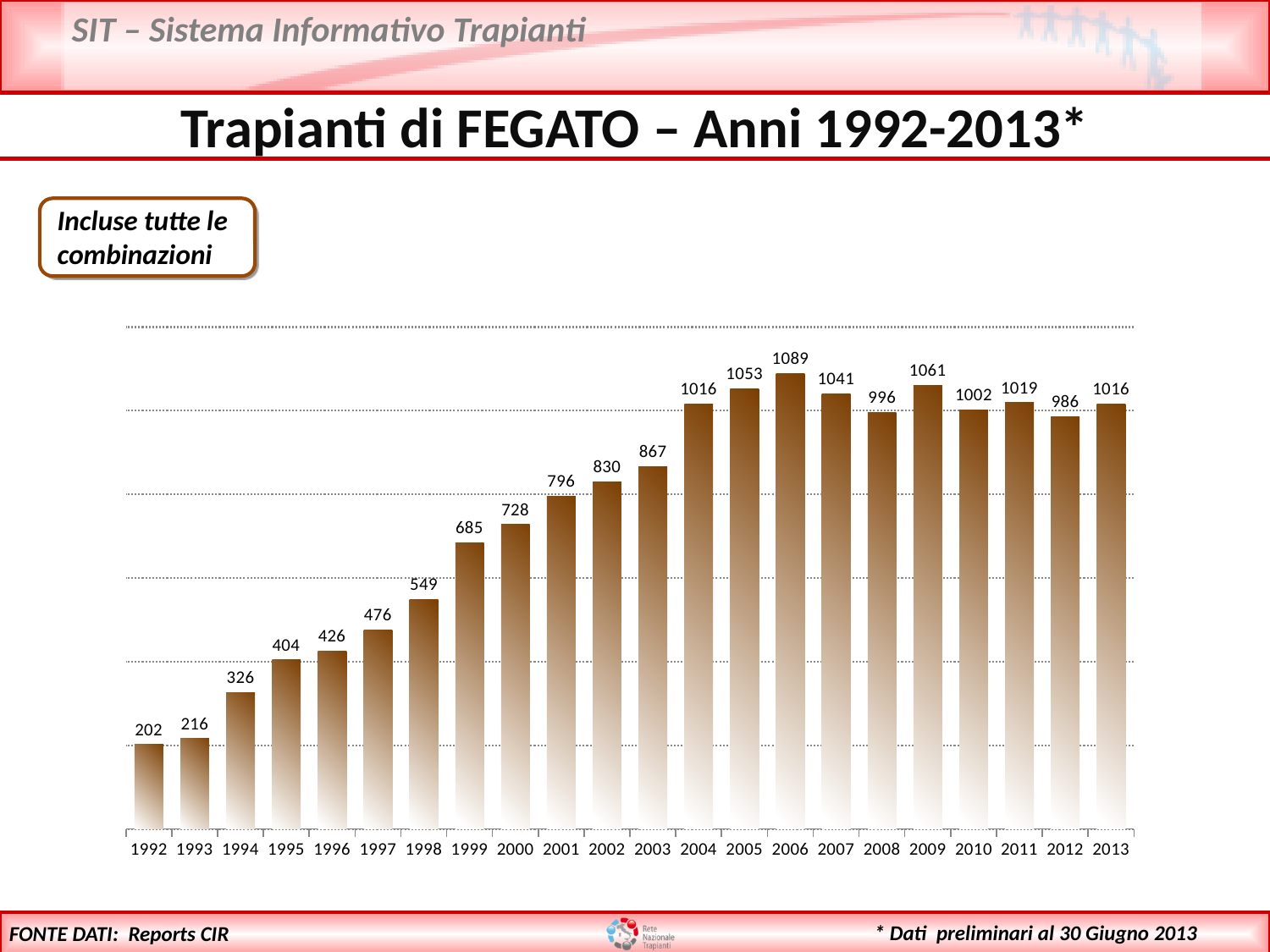
Which year has the highest value? 2006 What kind of chart is shown on the slide? bar chart What is the difference between the values for 2012 and 2013? 30 What is the difference between the values for 2006 and 1992? 887 Which is larger, the value for 2005 or the value for 2007? 2005 What is the title of the slide containing the chart? Trapianti di FEGATO – Anni 1992-2013* What is the value for 2006? 1089 How many years are shown on the x axis? 22 Which year has the lowest value? 1992 Do the values generally rise or fall from 1992 to 2006? rise What is the value for 2013? 1016 What is the value for 1992? 202